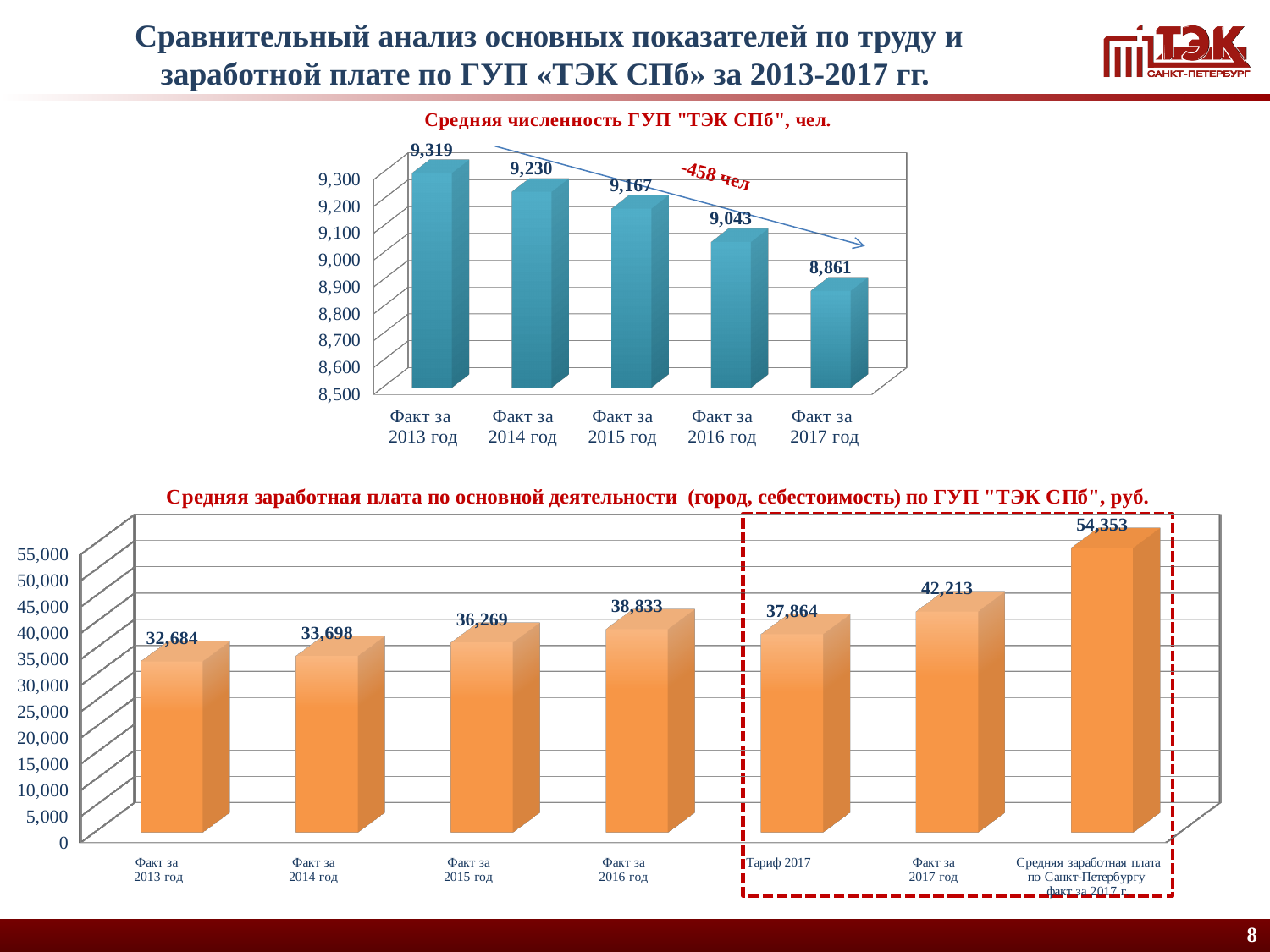
In the bottom chart (Средняя заработная плата), what is the difference between Факт за 2017 год and Факт за 2016 год? 3,380 In the bottom chart (Средняя заработная плата), what is the value for Тариф 2017? 37,864 In the top chart (Средняя численность ГУП "ТЭК СПб", чел.), which category has the lowest value? Факт за 2017 год In the bottom chart (Средняя заработная плата), what is the value for Факт за 2017 год? 42,213 In the top chart (Средняя численность ГУП "ТЭК СПб", чел.), do the values rise or fall from 2013 to 2017? fall What kind of chart is the bottom chart (Средняя заработная плата)? bar chart In the bottom chart (Средняя заработная плата), which is larger: Факт за 2016 год or Тариф 2017? Факт за 2016 год In the top chart (Средняя численность ГУП "ТЭК СПб", чел.), what is the difference between Факт за 2013 год and Факт за 2017 год? 458 In the bottom chart (Средняя заработная плата), which category has the highest value? Средняя заработная плата по Санкт-Петербургу факт за 2017 г. In the top chart (Средняя численность ГУП "ТЭК СПб", чел.), what is the value for Факт за 2017 год? 8,861 In the top chart (Средняя численность ГУП "ТЭК СПб", чел.), what is the value for Факт за 2013 год? 9,319 How many bars are in the top chart (Средняя численность ГУП "ТЭК СПб", чел.)? 5